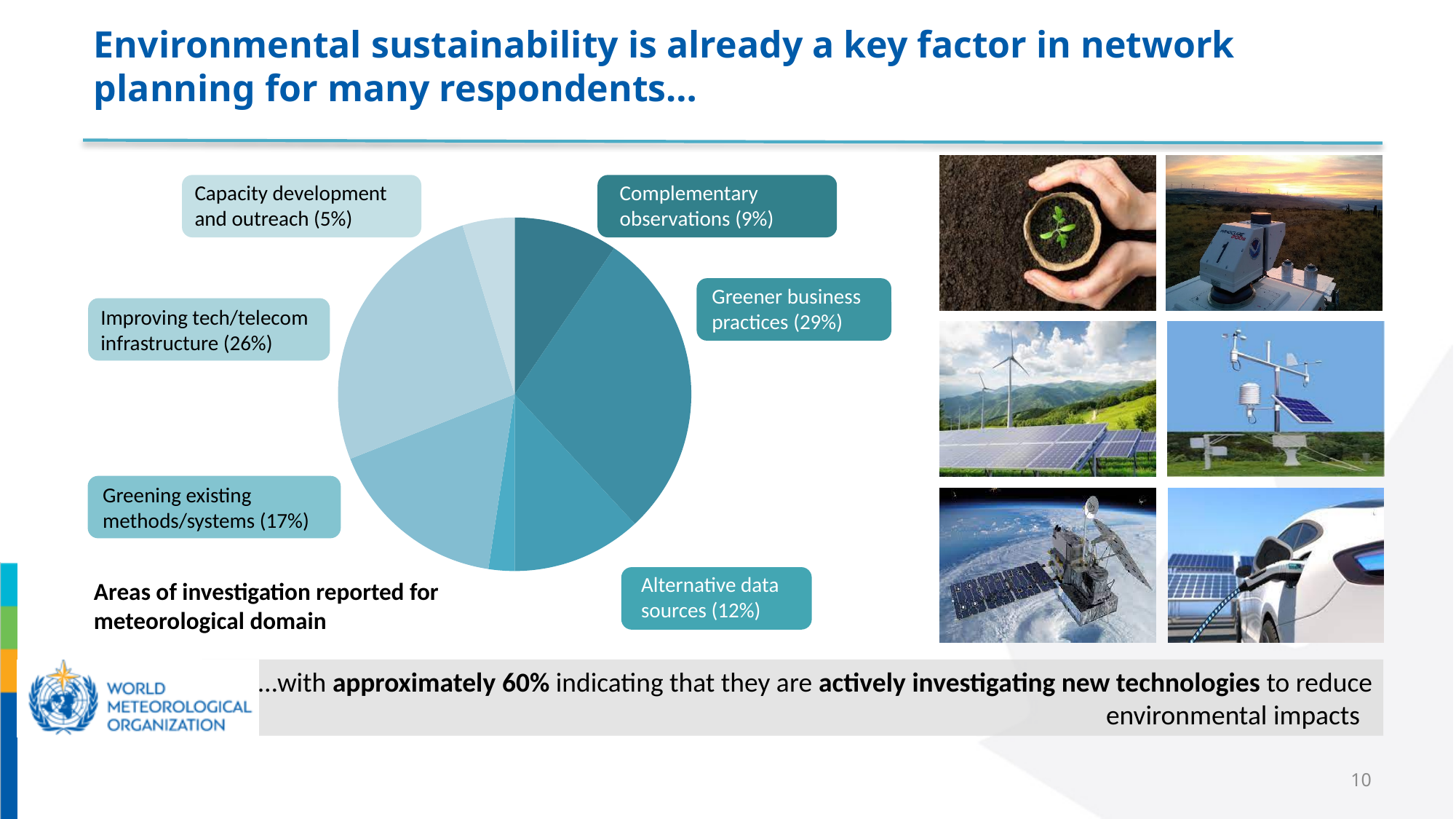
Which labelled area of investigation has the largest share of the pie? Greener business practices What type of chart is shown on the slide? Pie chart What percentage of the pie chart is Greener business practices? 29% Which is larger: Alternative data sources or Complementary observations? Alternative data sources What percentage is shown for Complementary observations? 9% What percentage is shown for Capacity development and outreach? 5% How many percentage points larger is Greener business practices than Greening existing methods/systems? 12 What is the caption below the pie chart? Areas of investigation reported for meteorological domain What share does Improving tech/telecom infrastructure have in the pie chart? 26% What percentage is shown for Greening existing methods/systems? 17% What percentage is shown for Alternative data sources? 12% Which labelled area of investigation has the smallest share of the pie? Capacity development and outreach